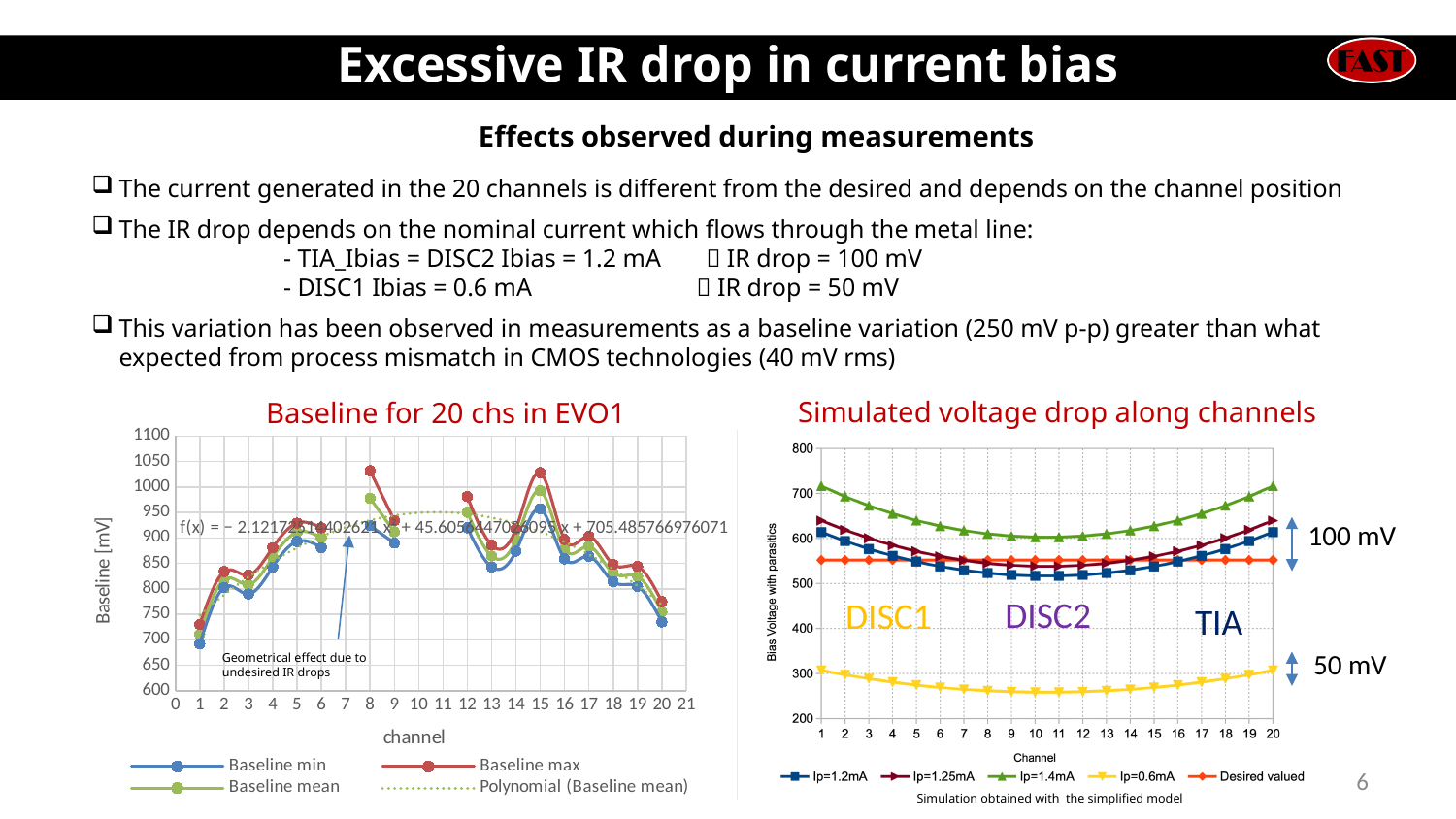
In the 'Baseline for 20 chs in EVO1' chart, is the Baseline min value at channel 20 greater or less than 750? less In the 'Simulated voltage drop along channels' chart, which series has the highest value at channel 10? Ip=1.4mA In the 'Baseline for 20 chs in EVO1' chart, is the Baseline max value at channel 8 greater or less than 1000? greater What is the x-axis title of the 'Simulated voltage drop along channels' chart? Channel In the 'Simulated voltage drop along channels' chart, does the Ip=1.4mA series rise or fall from channel 10 to channel 20? rise What is the y-axis title of the 'Baseline for 20 chs in EVO1' chart? Baseline [mV] What kind of chart is the 'Baseline for 20 chs in EVO1' chart? line chart How many series does the legend of the 'Simulated voltage drop along channels' chart list? 5 In the 'Simulated voltage drop along channels' chart, is the Ip=1.2mA value at channel 10 greater or less than 600? less How many channels are plotted on the x axis of the 'Simulated voltage drop along channels' chart? 20 How many series does the legend of the 'Baseline for 20 chs in EVO1' chart list? 4